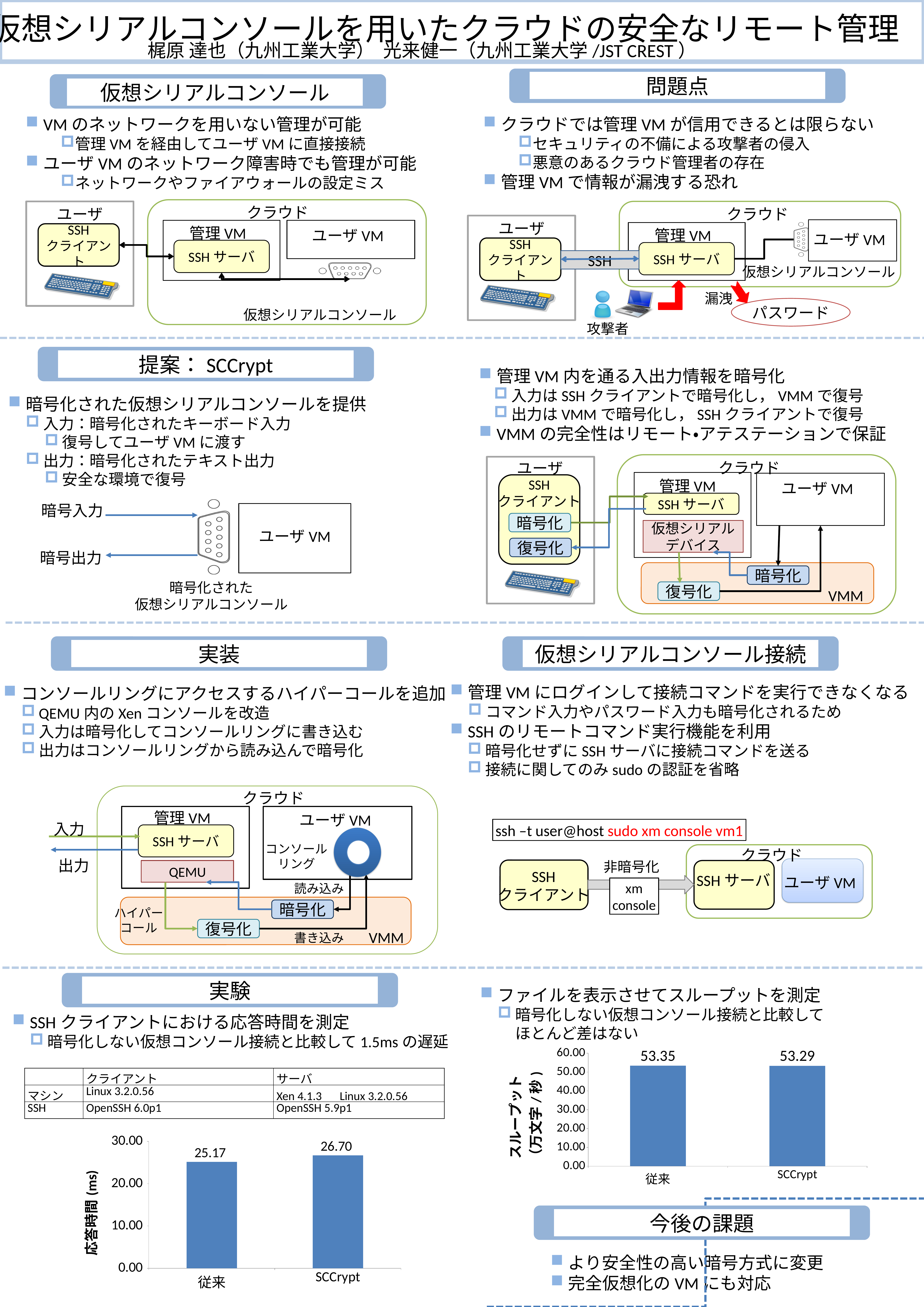
In the response time chart (応答時間 (ms)) at the bottom left, is the value for 従来 greater or less than 20.00? greater What kind of chart is the response time chart (応答時間 (ms)) at the bottom left? bar chart In the response time chart (応答時間 (ms)) at the bottom left, how many bars are plotted? 2 In the throughput chart (スループット (万文字/秒)) at the bottom right, what is the difference between 従来 and SCCrypt? 0.06 In the response time chart (応答時間 (ms)) at the bottom left, what is the difference between SCCrypt and 従来? 1.53 In the response time chart (応答時間 (ms)) at the bottom left, what is the value for 従来? 25.17 In the response time chart (応答時間 (ms)) at the bottom left, what is the value for SCCrypt? 26.70 What is the y-axis label of the throughput chart at the bottom right? スループット（万文字/秒） In the throughput chart (スループット (万文字/秒)) at the bottom right, is the value for SCCrypt greater or less than 50.00? greater In the throughput chart (スループット (万文字/秒)) at the bottom right, what is the value for 従来? 53.35 In the response time chart (応答時間 (ms)) at the bottom left, which category has the higher value? SCCrypt In the throughput chart (スループット (万文字/秒)) at the bottom right, what is the value for SCCrypt? 53.29